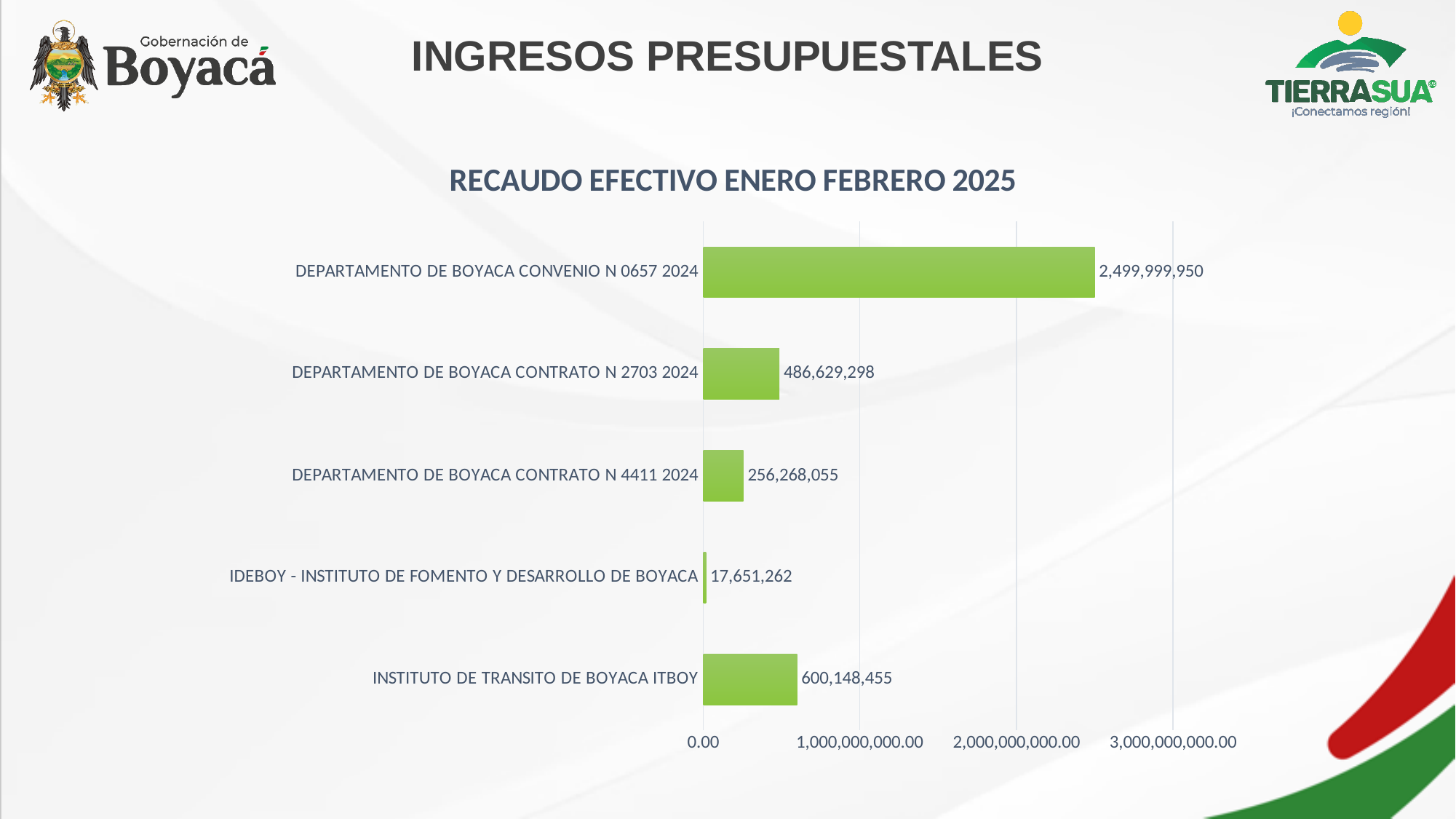
What is the value for DEPARTAMENTO DE BOYACA CONTRATO N 4411 2024? 256,268,055 What is the value for IDEBOY - INSTITUTO DE FOMENTO Y DESARROLLO DE BOYACA? 17,651,262 What is the difference between the values for DEPARTAMENTO DE BOYACA CONTRATO N 2703 2024 and DEPARTAMENTO DE BOYACA CONTRATO N 4411 2024? 230,361,243 Is the value for INSTITUTO DE TRANSITO DE BOYACA ITBOY greater or less than 1,000,000,000.00? less What is the difference between the values for INSTITUTO DE TRANSITO DE BOYACA ITBOY and DEPARTAMENTO DE BOYACA CONTRATO N 2703 2024? 113,519,157 What kind of chart is shown on the slide? Bar chart Which is larger, the value for DEPARTAMENTO DE BOYACA CONTRATO N 2703 2024 or the value for INSTITUTO DE TRANSITO DE BOYACA ITBOY? INSTITUTO DE TRANSITO DE BOYACA ITBOY Which category has the highest value? DEPARTAMENTO DE BOYACA CONVENIO N 0657 2024 What is the value for DEPARTAMENTO DE BOYACA CONVENIO N 0657 2024? 2,499,999,950 How many categories are shown in the chart? 5 Which category has the lowest value? IDEBOY - INSTITUTO DE FOMENTO Y DESARROLLO DE BOYACA What is the value for INSTITUTO DE TRANSITO DE BOYACA ITBOY? 600,148,455